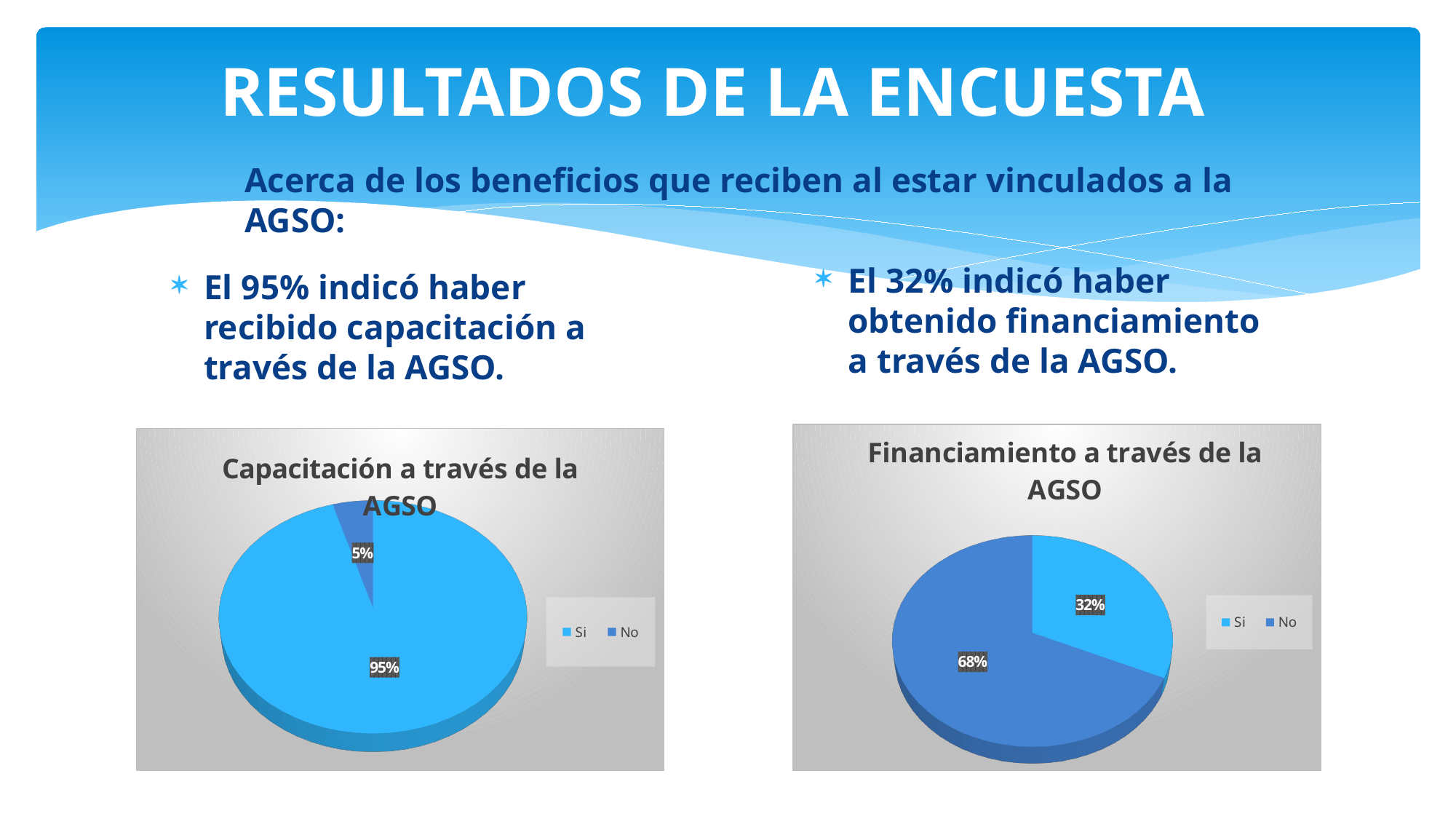
In the 'Capacitación a través de la AGSO' chart, which slice is the largest? Si In the 'Financiamiento a través de la AGSO' chart, what is the difference between the 'No' and 'Si' shares? 36% In the 'Capacitación a través de la AGSO' chart, what is the difference between the 'Si' and 'No' shares? 90% In the 'Financiamiento a través de la AGSO' chart, what share of the pie is 'Si'? 32% In the 'Financiamiento a través de la AGSO' chart, what share of the pie is 'No'? 68% How many categories does the legend of the 'Financiamiento a través de la AGSO' chart list? 2 In the 'Capacitación a través de la AGSO' chart, what share of the pie is 'Si'? 95% In the 'Financiamiento a través de la AGSO' chart, which is larger, 'Si' or 'No'? No What is the title of the chart on the right side of the slide? Financiamiento a través de la AGSO What kind of chart is the 'Capacitación a través de la AGSO' chart? Pie chart In the 'Financiamiento a través de la AGSO' chart, which slice is the smallest? Si